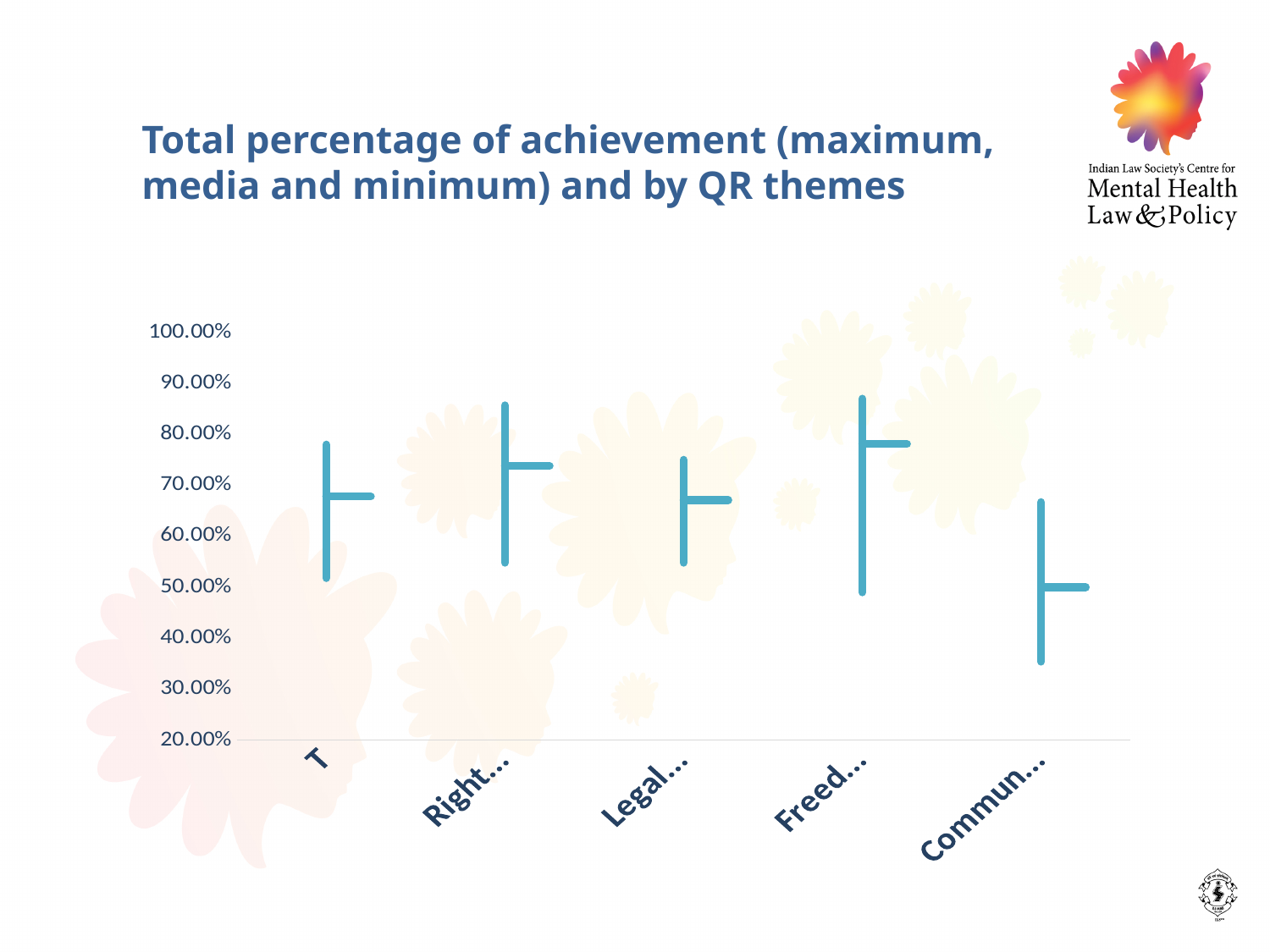
What is the lowest value shown on the vertical axis? 20.00% Is the maximum value for the 'Freed...' category greater or less than 80%? greater Is the middle (median) marker for the 'Commun...' category greater or less than 60%? less Which category has a higher middle (median) marker, 'Freed...' or 'Commun...'? Freed... Is the maximum value for the 'Legal...' category greater or less than 80%? less Which category has the lowest middle (median) marker? Commun... How many QR theme categories are plotted on the chart? 5 Which category has the lowest minimum value? Commun... What kind of chart is shown on the slide? high-low chart What is the title of the chart on the slide? Total percentage of achievement (maximum, media and minimum) and by QR themes